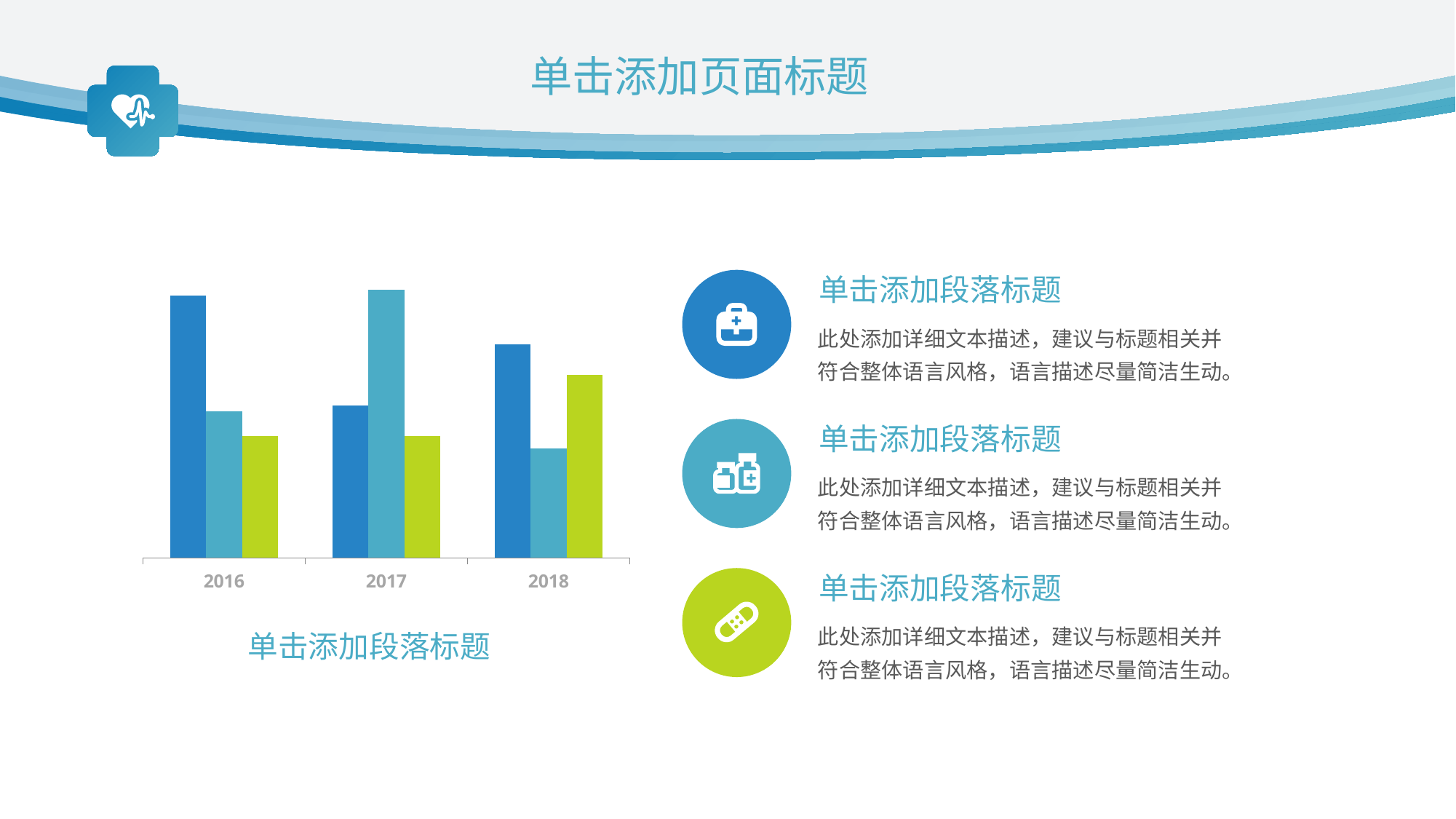
Does the green bar rise or fall from 2017 to 2018? rise How many categories are shown on the x axis of the chart? 3 Which year has the shortest dark blue bar? 2017 In 2018, which bar is taller, the green bar or the light blue bar? green Which year has the tallest green bar? 2018 What kind of chart is shown on the slide? bar chart Which year has the tallest light blue bar? 2017 In 2016, which bar is taller, the dark blue bar or the green bar? dark blue Which year has the shortest light blue bar? 2018 How many bars are plotted for each year in the chart? 3 What are the category labels on the x axis of the chart? 2016, 2017, 2018 Which year has the tallest dark blue bar? 2016